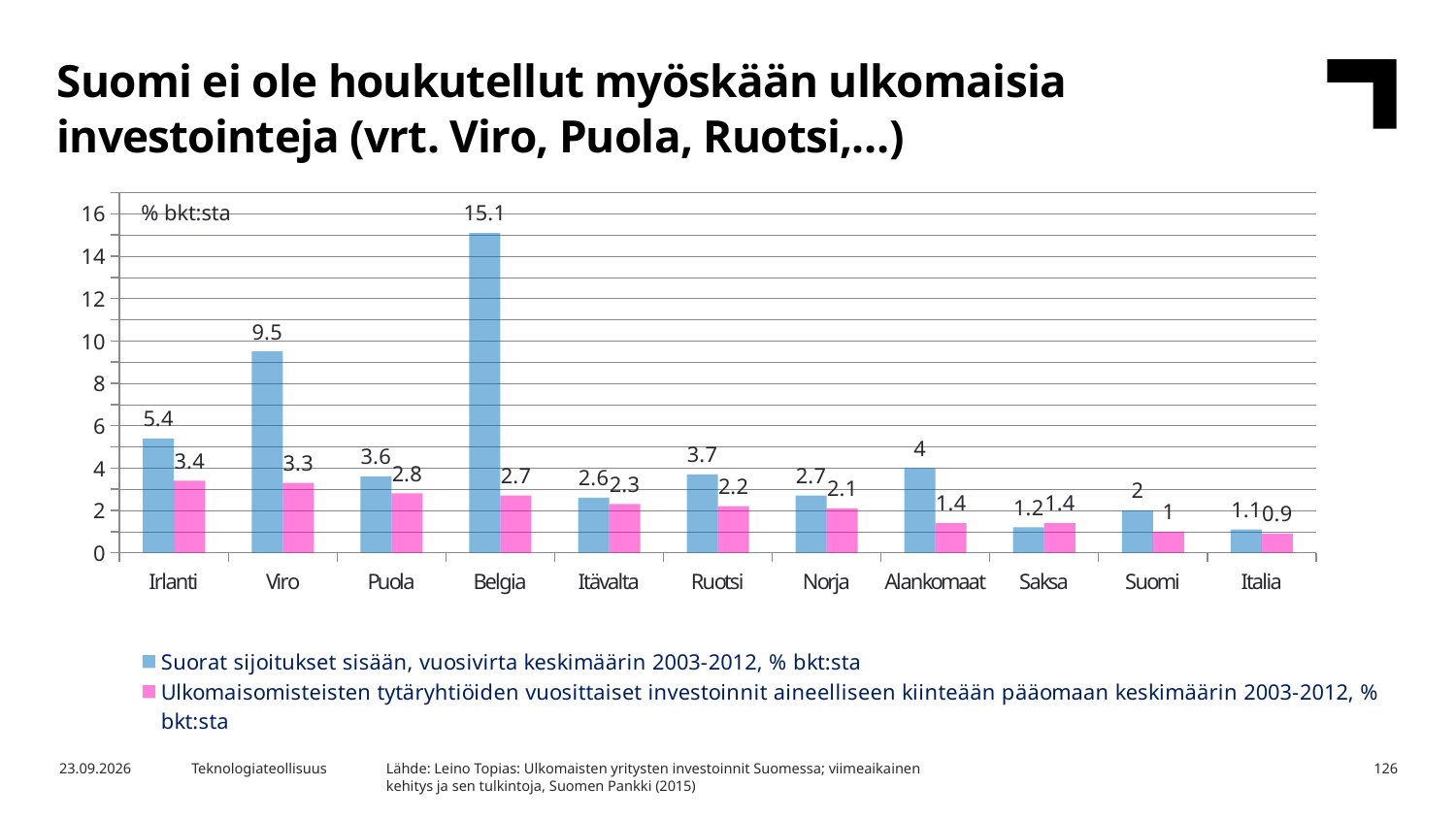
What is the total of the blue and pink values for Irlanti? 8.8 What is the value of the pink series (Ulkomaisomisteisten tytäryhtiöiden investoinnit) for Suomi? 1 What is the difference between the blue series values for Viro and Suomi? 7.5 Which is larger for Saksa: the blue series value or the pink series value? The pink series value (1.4) What is the value of the blue series (Suorat sijoitukset sisään) for Belgia? 15.1 What is the value of the blue series for Viro? 9.5 Which country has the lowest value in the pink series (Ulkomaisomisteisten tytäryhtiöiden investoinnit)? Italia Which country has the highest value in the blue series (Suorat sijoitukset sisään)? Belgia What kind of chart is shown on the slide? Bar chart What unit label is shown at the top left of the chart's plot area? % bkt:sta How many countries are shown on the x axis? 11 How many series does the legend list? 2